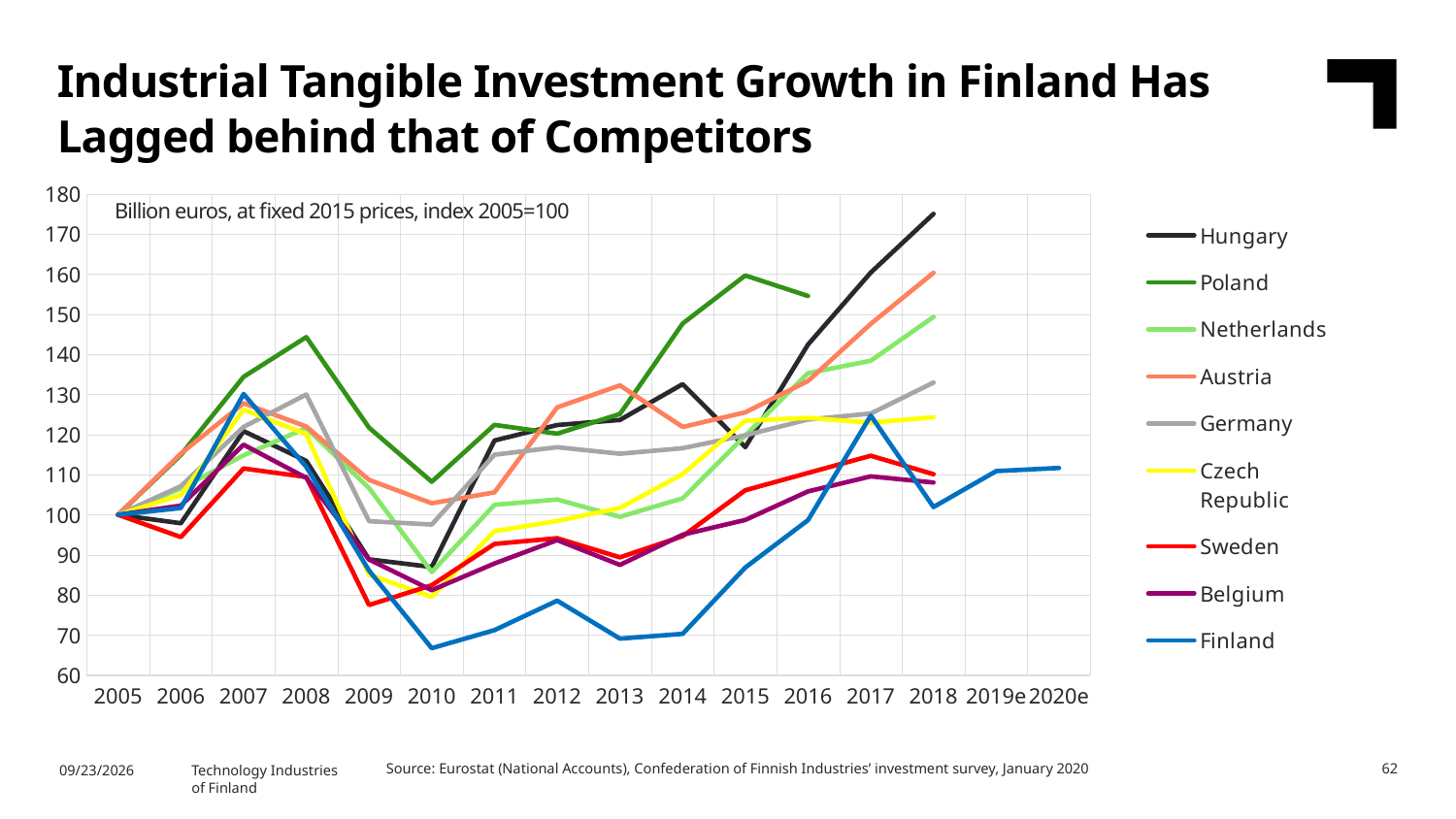
What is the index value for Finland in 2005? 100 Which country has the lowest value in 2010? Finland Is the value for Poland in 2015 greater or less than 150? greater In 2014, which is larger, the value for Poland or the value for Finland? Poland Is the value for Finland in 2010 greater or less than 80? less Is the value for Hungary in 2018 greater or less than 170? greater How many years are shown along the x axis? 16 What kind of chart is shown on the slide? Line chart Which series is the only one that extends to 2020e? Finland Which country has the highest value in 2018? Hungary How many series does the legend list? 9 Does the value for Hungary rise or fall from 2015 to 2018? Rise